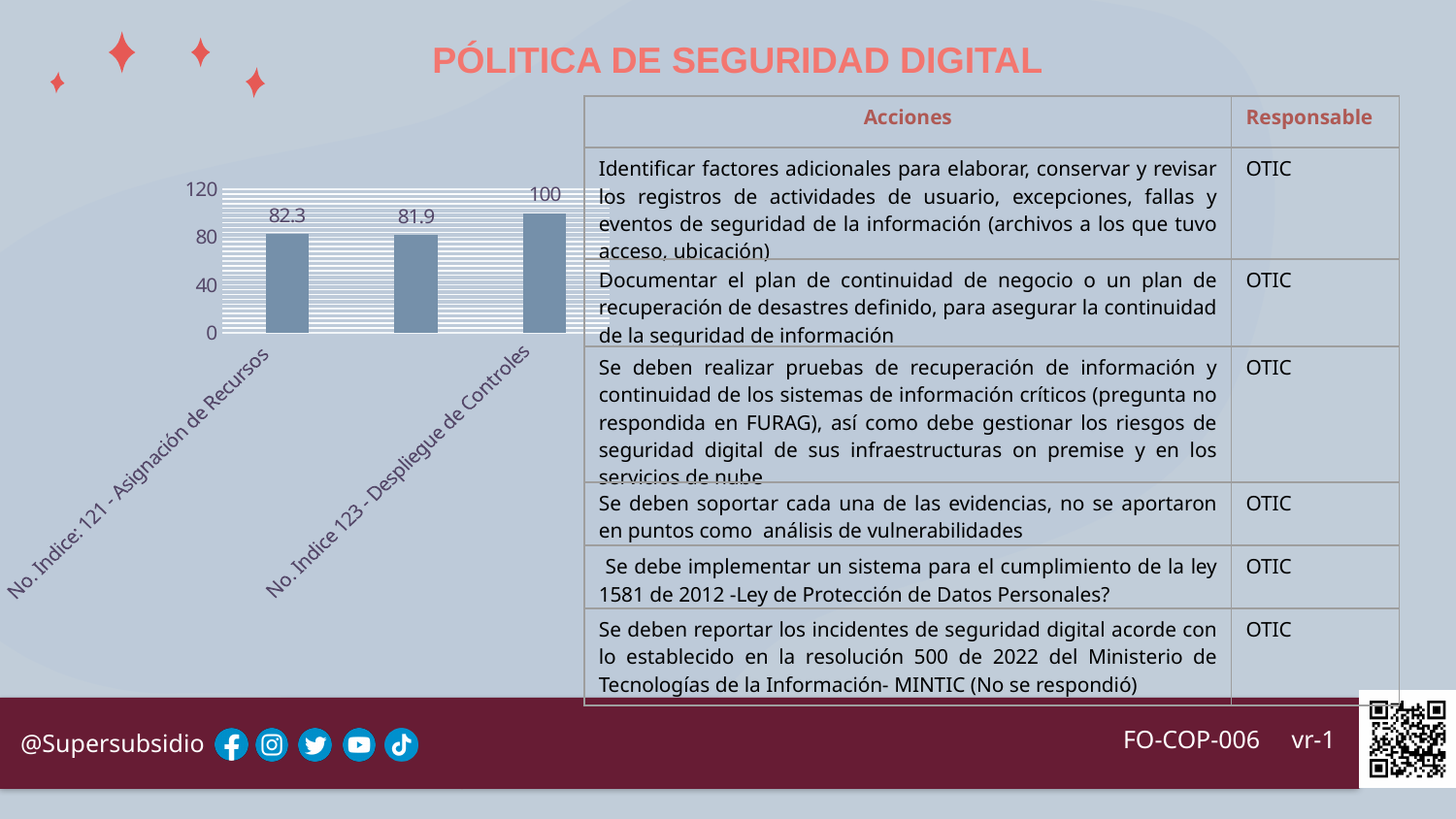
How many bars are plotted in the chart? 3 What is the value for 'No. Indice: 121 - Asignación de Recursos'? 82.3 What is the difference between the values for 'No. Indice: 121 - Asignación de Recursos' and 'No. Indice 123 - Despliegue de Controles'? 17.7 Is the value for 'No. Indice 123 - Despliegue de Controles' greater or less than 80? greater Which is larger: the value for 'No. Indice: 121 - Asignación de Recursos' or 'No. Indice 123 - Despliegue de Controles'? No. Indice 123 - Despliegue de Controles What is the highest value shown in the chart? 100 What kind of chart is shown on the slide? bar chart What is the highest tick value shown on the vertical axis of the chart? 120 What is the value of the third (rightmost) bar in the chart? 100 What is the difference between the rightmost bar's value and the value for 'No. Indice: 121 - Asignación de Recursos'? 17.7 What is the value for 'No. Indice 123 - Despliegue de Controles'? 100